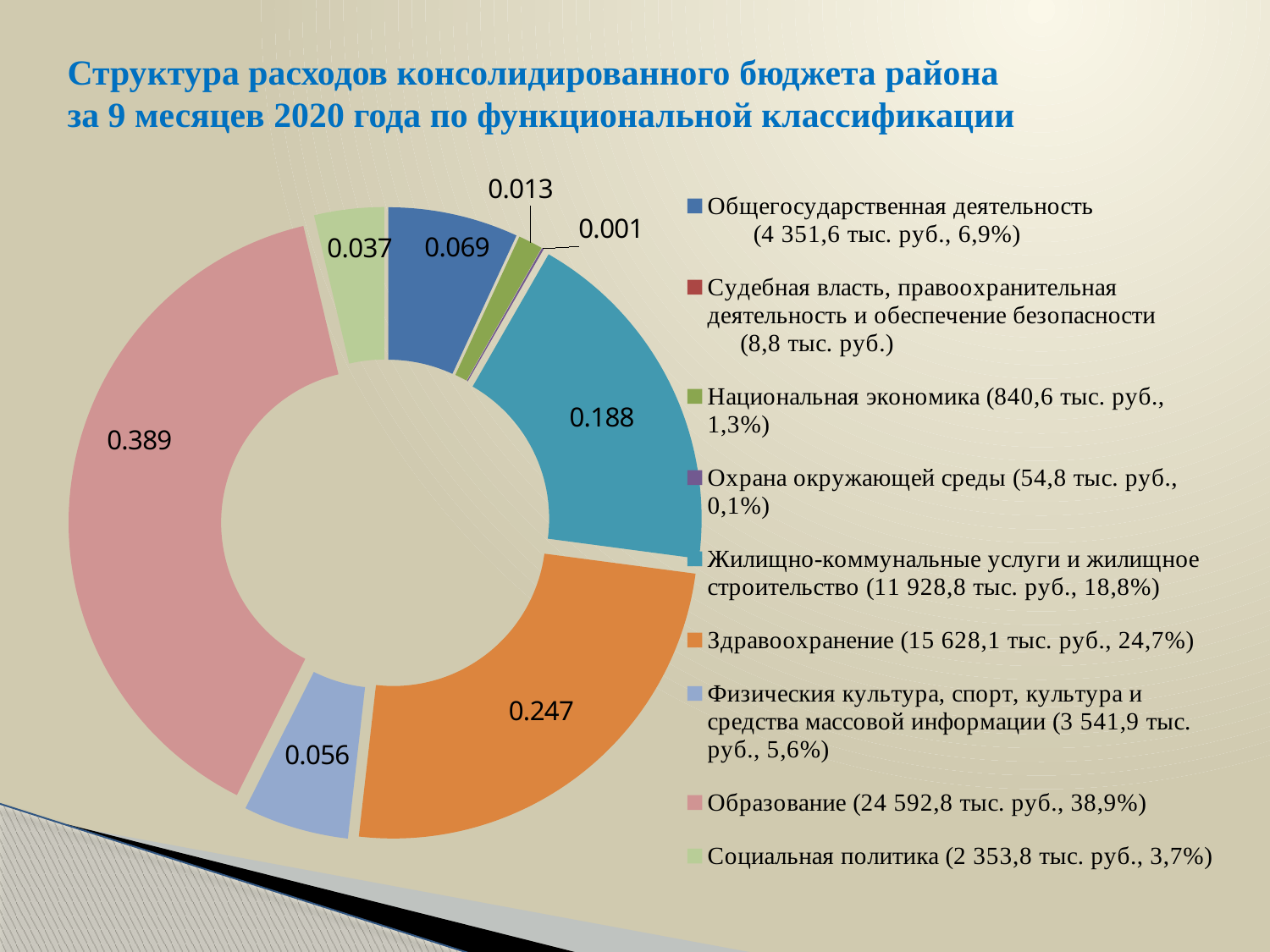
What is the data label shown for the Общегосударственная деятельность slice? 0.069 What is the difference between the data labels for Образование and Здравоохранение? 0.142 What is the data label shown for the Здравоохранение slice? 0.247 What is the data label shown for the Жилищно-коммунальные услуги и жилищное строительство slice? 0.188 What percentage does the legend give for Здравоохранение? 24,7% Which category has the largest slice of the chart? Образование Which of the two slices is larger: Здравоохранение or Жилищно-коммунальные услуги и жилищное строительство? Здравоохранение What is the data label shown for the Социальная политика slice? 0.037 According to the legend, what amount in тыс. руб. is given for Образование? 24 592,8 тыс. руб. How many entries does the legend list? 9 What is the data label shown for the Образование slice? 0.389 What kind of chart is shown on the slide? Doughnut (pie) chart